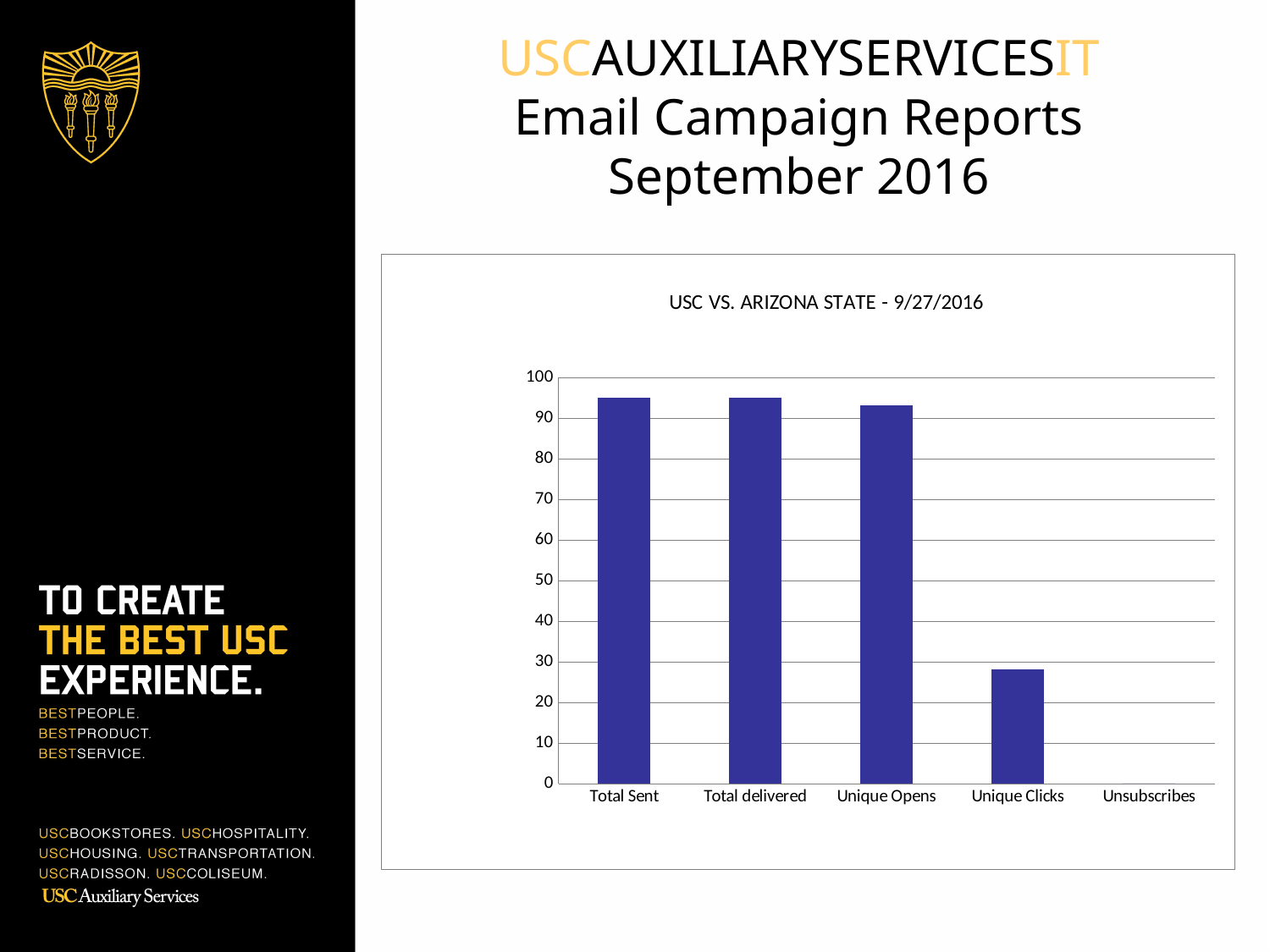
What kind of chart is shown on the slide? bar chart Do the values generally rise or fall moving from left to right along the x axis? fall Is the value for Unique Clicks greater or less than 20? greater Which category has the lowest value in the chart? Unsubscribes Is the value for Unique Opens greater or less than 90? greater What is the highest value shown on the y axis of the chart? 100 Is the value for Total Sent greater or less than 90? greater How many categories are shown on the x axis of the chart? 5 Which is larger, the value for Unique Opens or the value for Unique Clicks? Unique Opens What is the title of the chart? USC VS. ARIZONA STATE - 9/27/2016